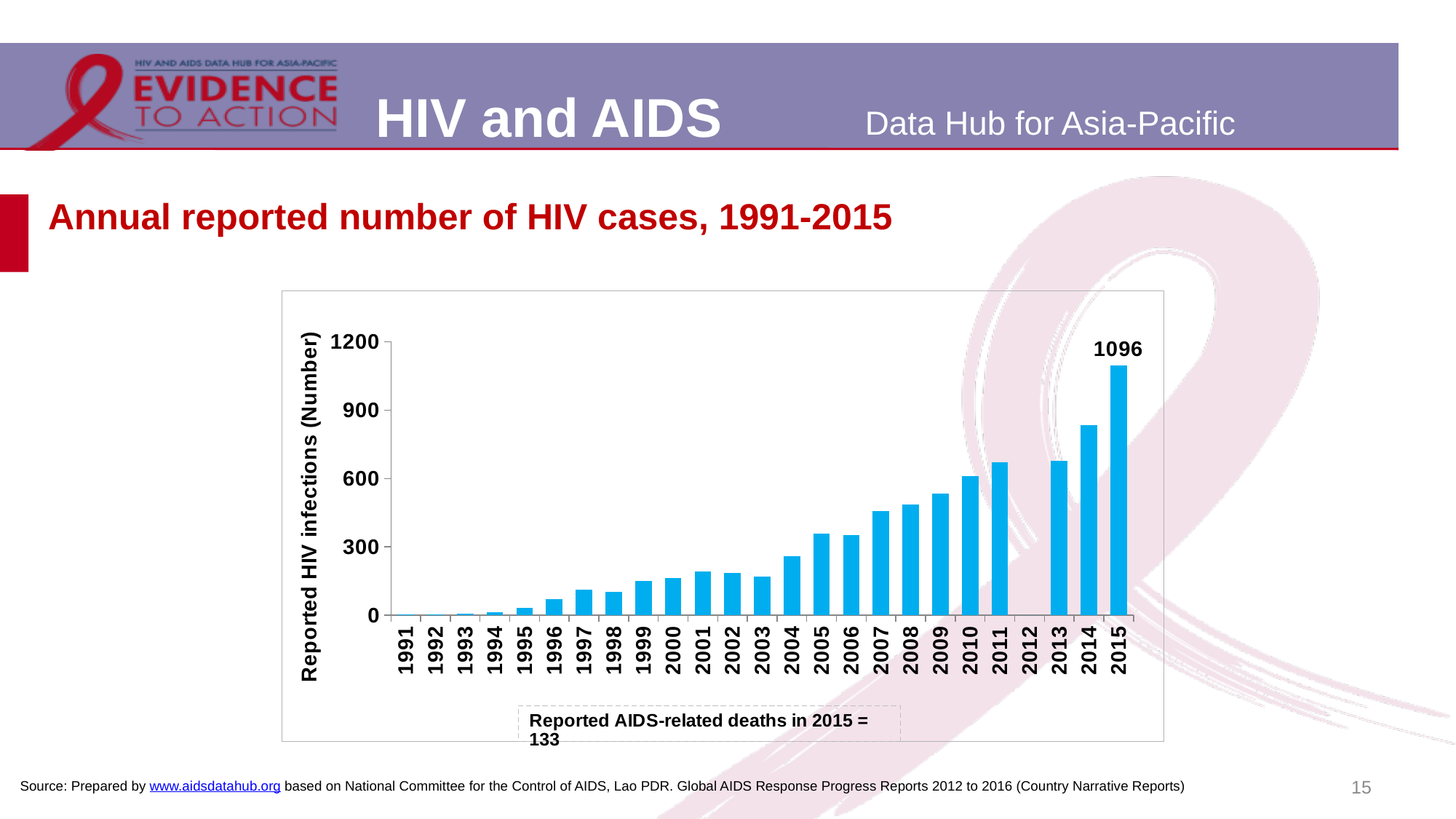
What is the title of the y axis? Reported HIV infections (Number) Which year has the larger value, 2013 or 2014? 2014 According to the text box on the chart, how many AIDS-related deaths were reported in 2015? 133 What kind of chart is shown on the slide? bar chart What is the reported number of HIV cases in 2015? 1096 Which year has the highest reported number of HIV cases? 2015 Is the value for 2014 greater or less than 900? less Is the value for 2004 greater or less than 300? less Is the value for 2011 greater or less than 600? greater Do the reported HIV cases generally rise or fall from 1991 to 2015? rise How many years are shown on the x axis of the chart? 25